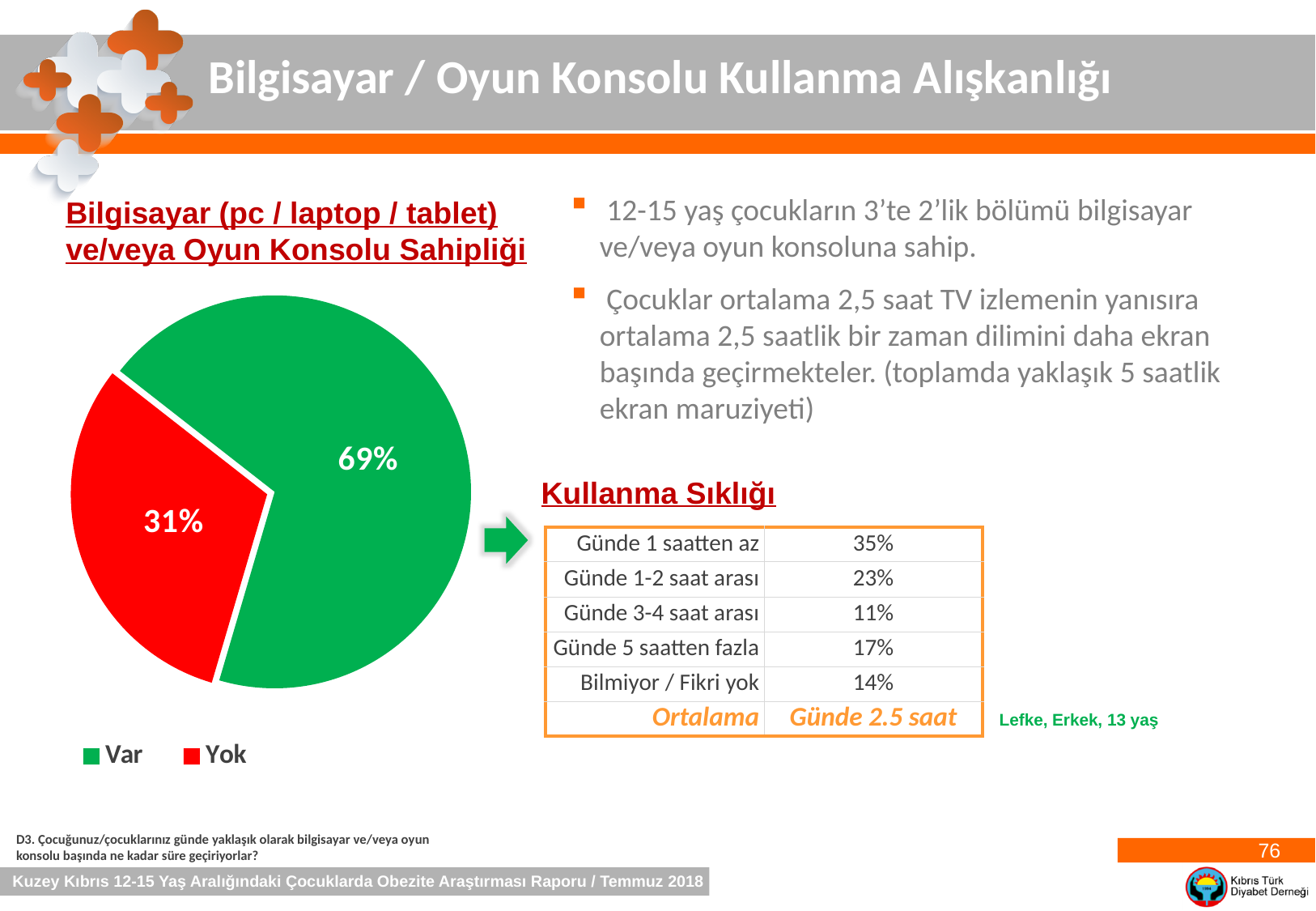
What colour is the "Var" slice in the pie chart? green Which slice of the pie chart is the largest? Var Which is larger in the pie chart, "Var" or "Yok"? Var How many slices does the pie chart have? 2 What colour is the "Yok" slice in the pie chart? red What kind of chart is shown on the slide? pie chart Which slice of the pie chart is the smallest? Yok What share of the pie chart is labelled "Yok"? 31% What is the difference in percentage points between the "Var" and "Yok" slices? 38 What share of the pie chart is labelled "Var"? 69% Is the share of the "Yok" slice greater or less than 50%? less How many entries does the pie chart's legend list? 2